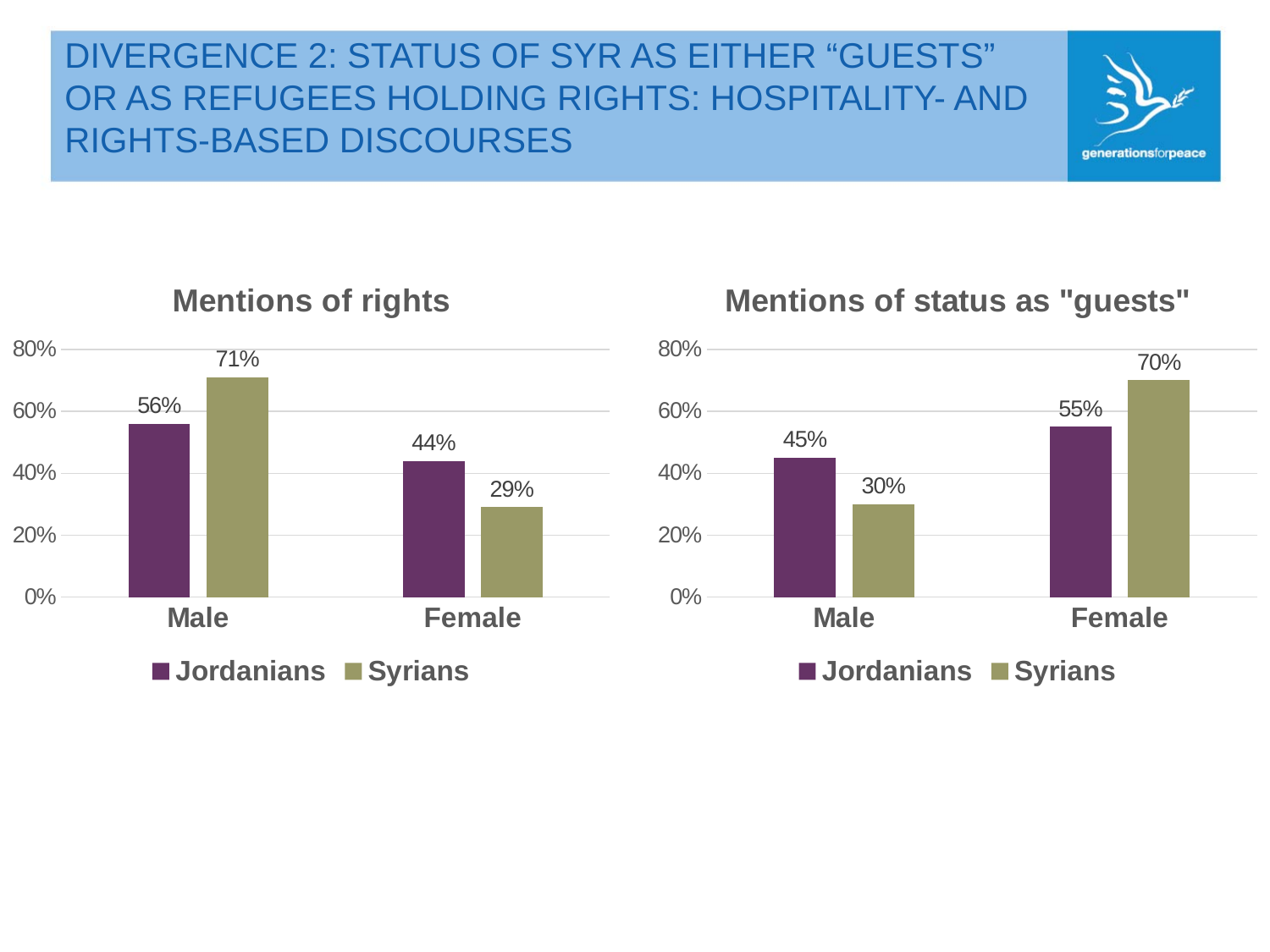
In the "Mentions of rights" chart, what is the difference between the Syrians and Jordanians values for Male? 15% What kind of chart is the "Mentions of status as "guests"" chart? Bar chart In the "Mentions of status as "guests"" chart, what is the difference between the Jordanians and Syrians values for Male? 15% In the "Mentions of rights" chart, which bar has the lowest value? Syrians, Female In the "Mentions of rights" chart, what is the value for Syrians in the Male category? 71% In the "Mentions of status as "guests"" chart, what is the value for Syrians in the Female category? 70% In the "Mentions of rights" chart, which colour represents Jordanians? Purple In the "Mentions of status as "guests"" chart, which is larger for Female: Jordanians or Syrians? Syrians How many series does the legend of the "Mentions of rights" chart list? 2 In the "Mentions of rights" chart, what is the value for Jordanians in the Female category? 44% In the "Mentions of status as "guests"" chart, which bar has the highest value? Syrians, Female In the "Mentions of status as "guests"" chart, what is the value for Jordanians in the Male category? 45%